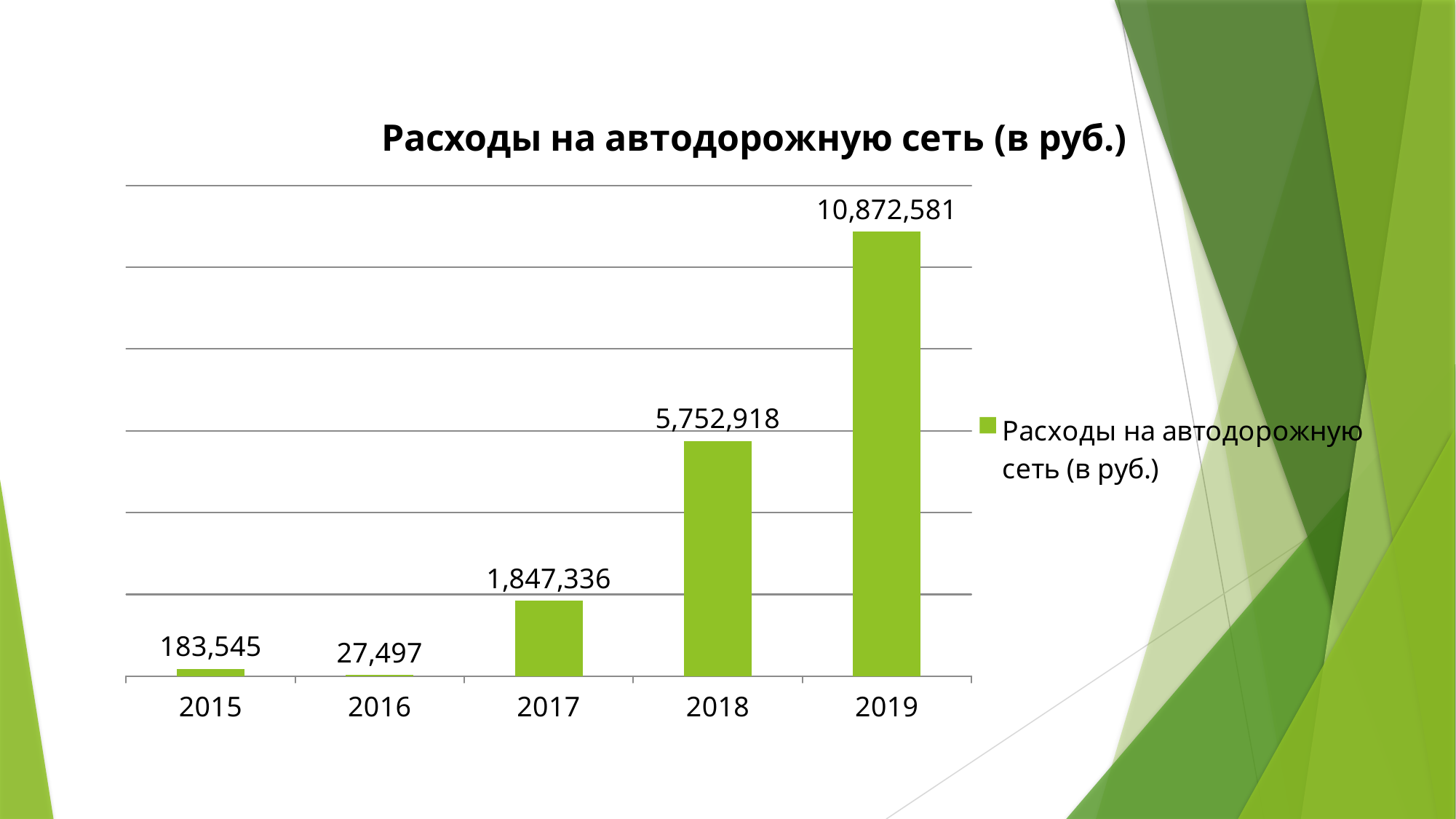
What is the value for 2016? 27,497 Which is larger, the value for 2017 or the value for 2018? 2018 How many years are shown on the x axis? 5 What is the value for 2019? 10,872,581 What kind of chart is this? bar chart Which year has the lowest value? 2016 From 2017 to 2019, do the values rise or fall? rise What is the value for 2017? 1,847,336 What is the difference between the values for 2019 and 2018? 5,119,663 Which year has the highest value? 2019 What is the difference between the values for 2015 and 2016? 156,048 What is the value for 2015? 183,545